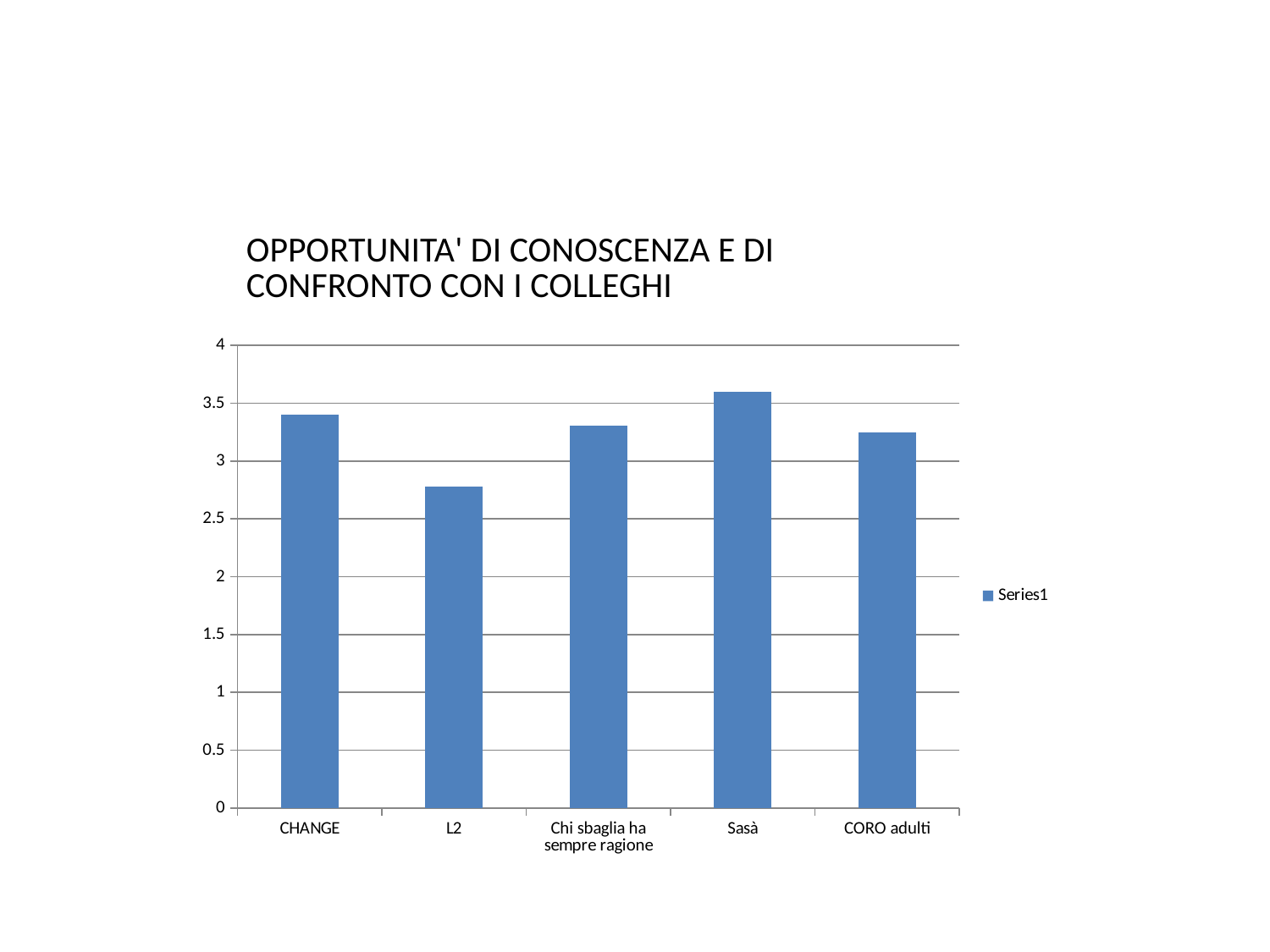
How many categories are shown on the x axis? 5 Which is larger, the value for CHANGE or the value for L2? CHANGE Which category has the lowest value? L2 What kind of chart is shown on the slide? bar chart Which is larger, the value for Sasà or the value for CORO adulti? Sasà Is the value for Chi sbaglia ha sempre ragione greater or less than 3.5? less Which category has the highest value? Sasà What is the title of the chart? OPPORTUNITA' DI CONOSCENZA E DI CONFRONTO CON I COLLEGHI How many series does the legend list? 1 Is the value for L2 greater or less than 3? less Is the value for CHANGE greater or less than 3? greater